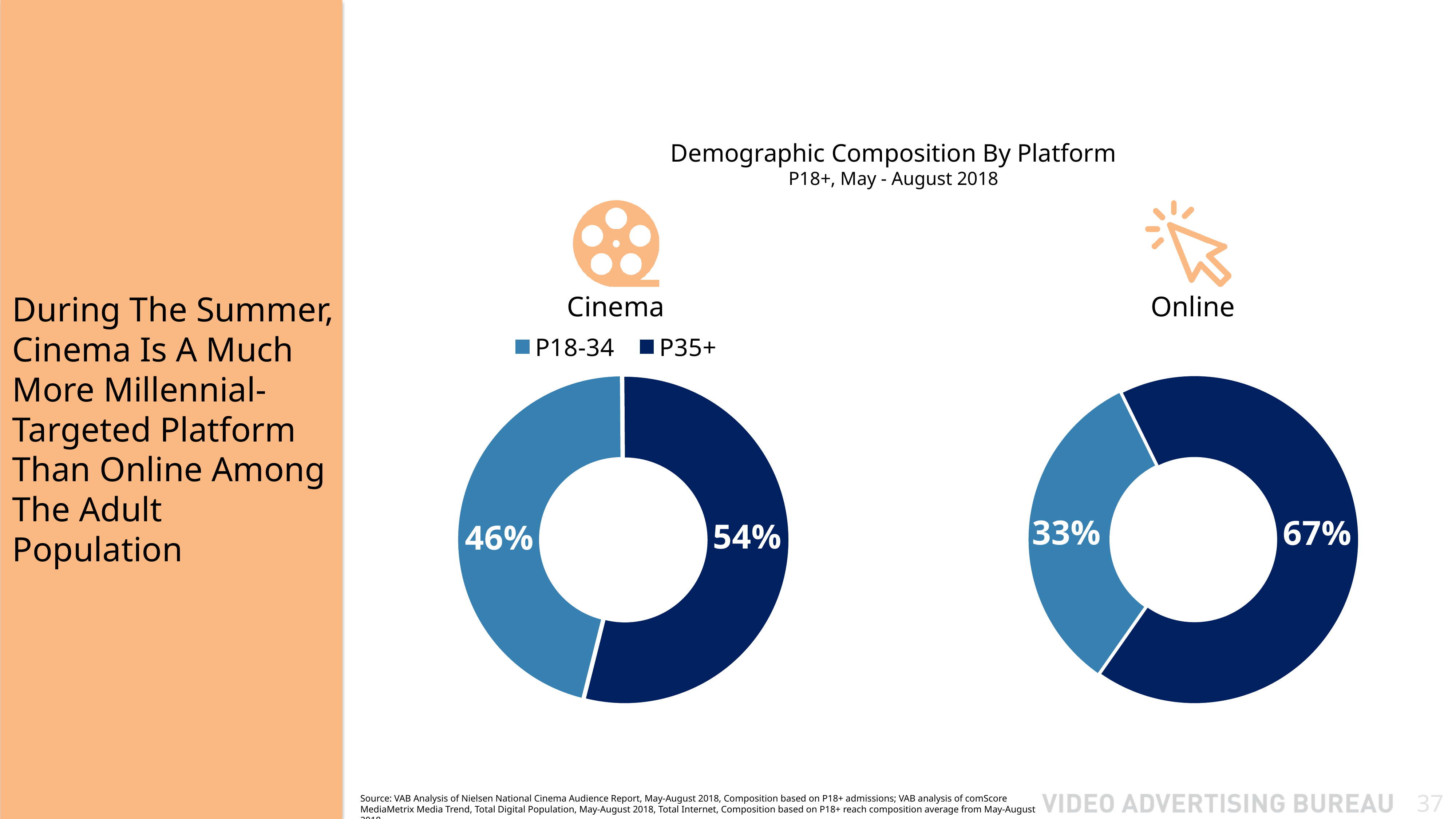
In the Online chart, which segment is the largest? P35+ What is the difference between the P35+ share and the P18-34 share in the Online chart? 34% How many segments does the Cinema chart have? 2 In the Online chart, what share is P35+? 67% What is the title shown above the charts? Demographic Composition By Platform In the Online chart, what share is P18-34? 33% In the Cinema chart, which segment is the smallest? P18-34 In the Cinema chart, what share is P35+? 54% In the Cinema chart, what share is P18-34? 46% What kind of chart is the Online chart? Doughnut chart Which platform has the larger P18-34 share, Cinema or Online? Cinema How many entries does the legend list? 2